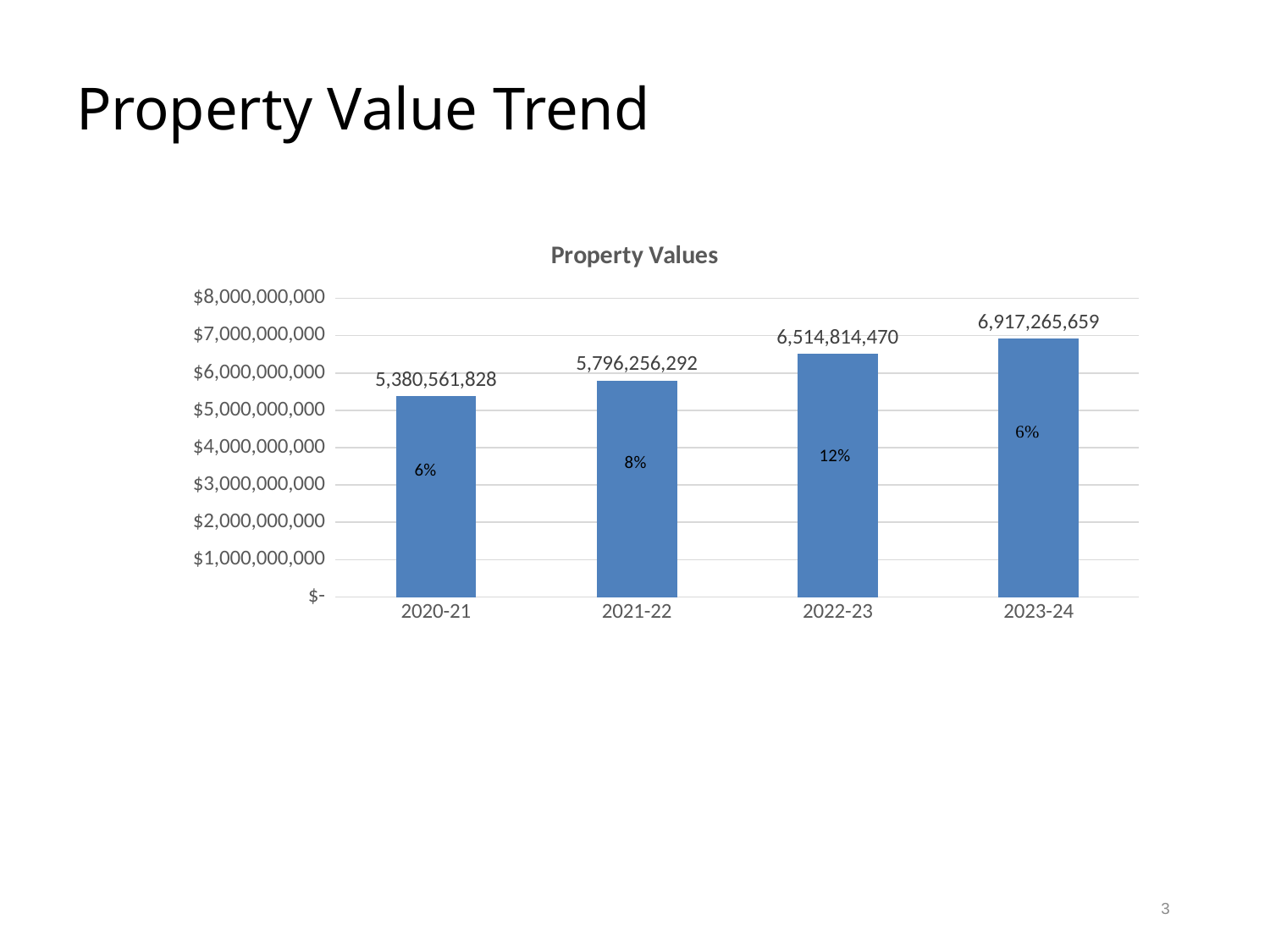
What is the difference in property value between 2023-24 and 2022-23? 402,451,189 What is the property value for 2023-24? 6,917,265,659 What percentage is shown inside the bar for 2021-22? 8% What percentage is shown inside the bar for 2022-23? 12% Do property values rise or fall from 2020-21 to 2023-24? rise What is the property value for 2020-21? 5,380,561,828 How many years are shown on the chart? 4 What is the property value for 2022-23? 6,514,814,470 Which year has the highest property value? 2023-24 Which year has the lowest property value? 2020-21 Which is larger, the property value for 2021-22 or for 2022-23? 2022-23 What is the difference in property value between 2022-23 and 2021-22? 718,558,178